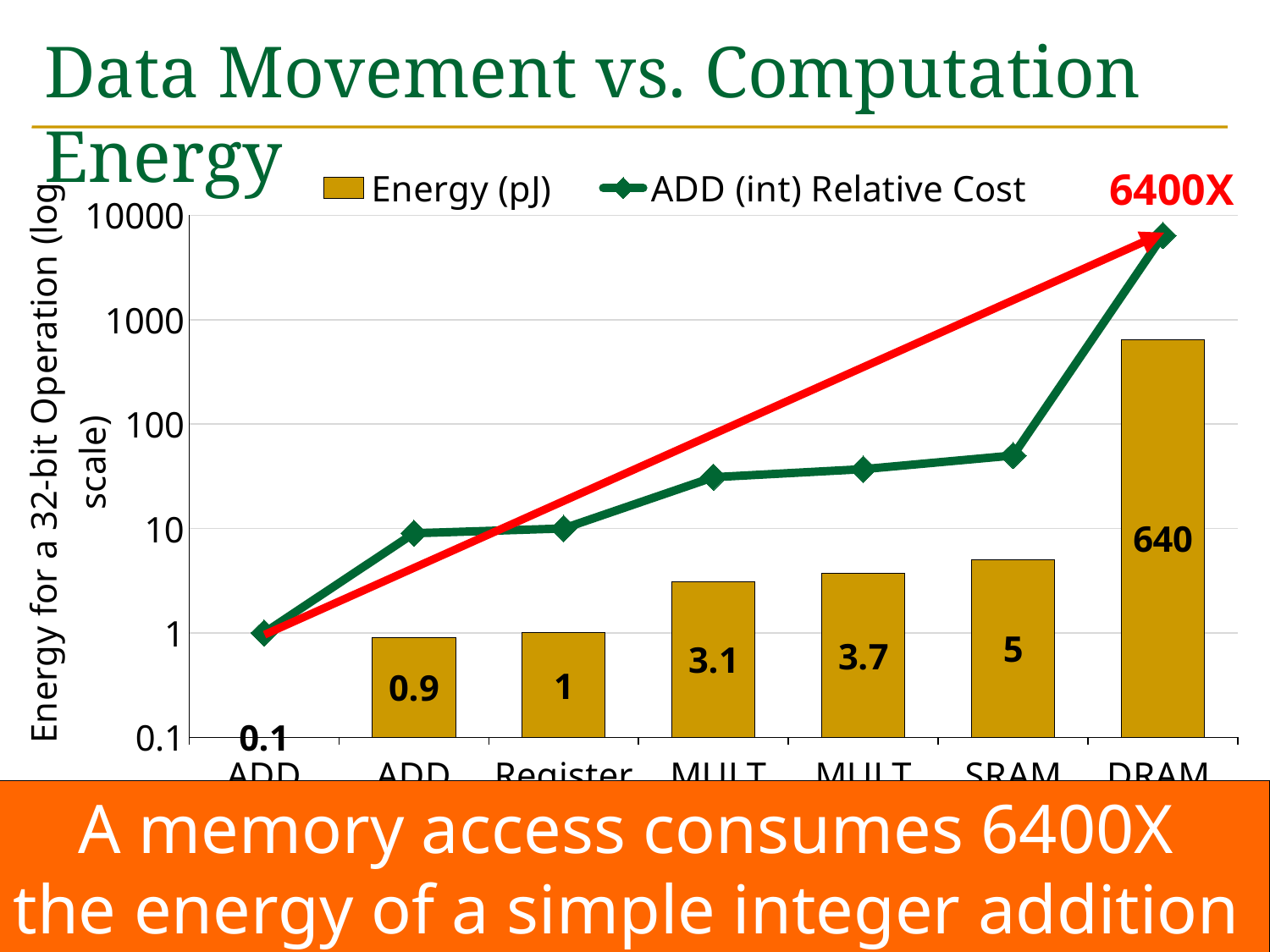
What is the Energy (pJ) value shown for DRAM? 640 What kind of chart is this? Combined bar and line chart What is the Energy (pJ) value shown for SRAM? 5 How many series does the legend list? 2 Is the ADD (int) Relative Cost value at DRAM greater or less than 1000? greater Is the ADD (int) Relative Cost value at SRAM greater or less than 10? greater Which category has the highest Energy (pJ) bar? DRAM Which category has the lowest Energy (pJ) value? ADD (the first category, 0.1) Which has a larger Energy (pJ) value, SRAM or Register? SRAM What is the Energy (pJ) value shown for Register? 1 What is the difference between the Energy (pJ) values for DRAM and SRAM? 635 How many categories are shown on the x axis? 7